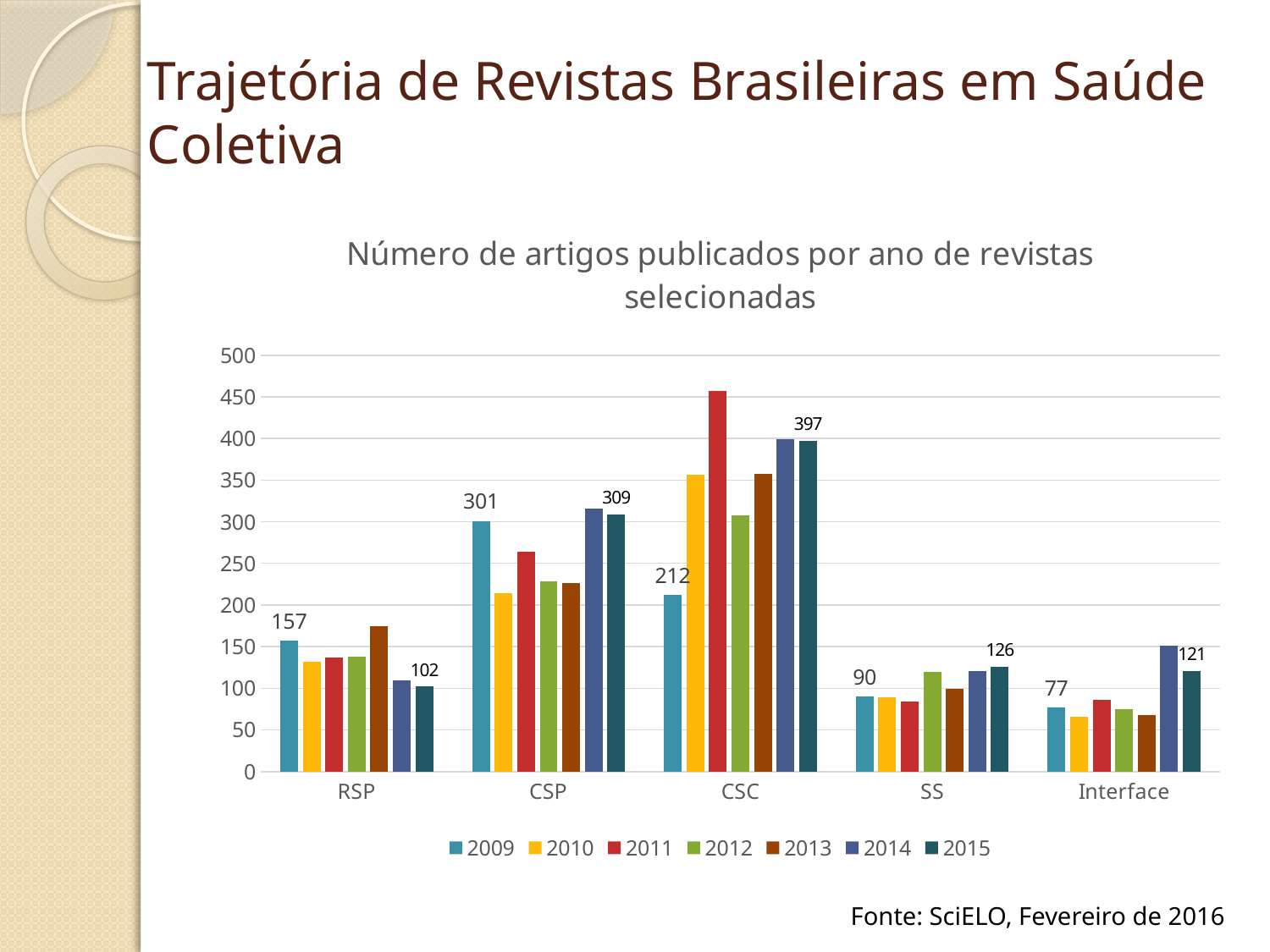
Is the value for CSP in 2011 greater or less than 250? greater What is the value for CSC in 2015? 397 Which is larger for SS: the 2009 value or the 2015 value? 2015 How many journal categories are shown on the x axis? 5 What is the chart's title? Número de artigos publicados por ano de revistas selecionadas Which journal has the highest 2011 value? CSC What is the difference between the 2009 and 2015 values for RSP? 55 How many series does the legend list? 7 What is the difference between the 2015 and 2009 values for CSC? 185 What kind of chart is shown on the slide? bar chart What is the value for Interface in 2009? 77 What is the value for RSP in 2009? 157